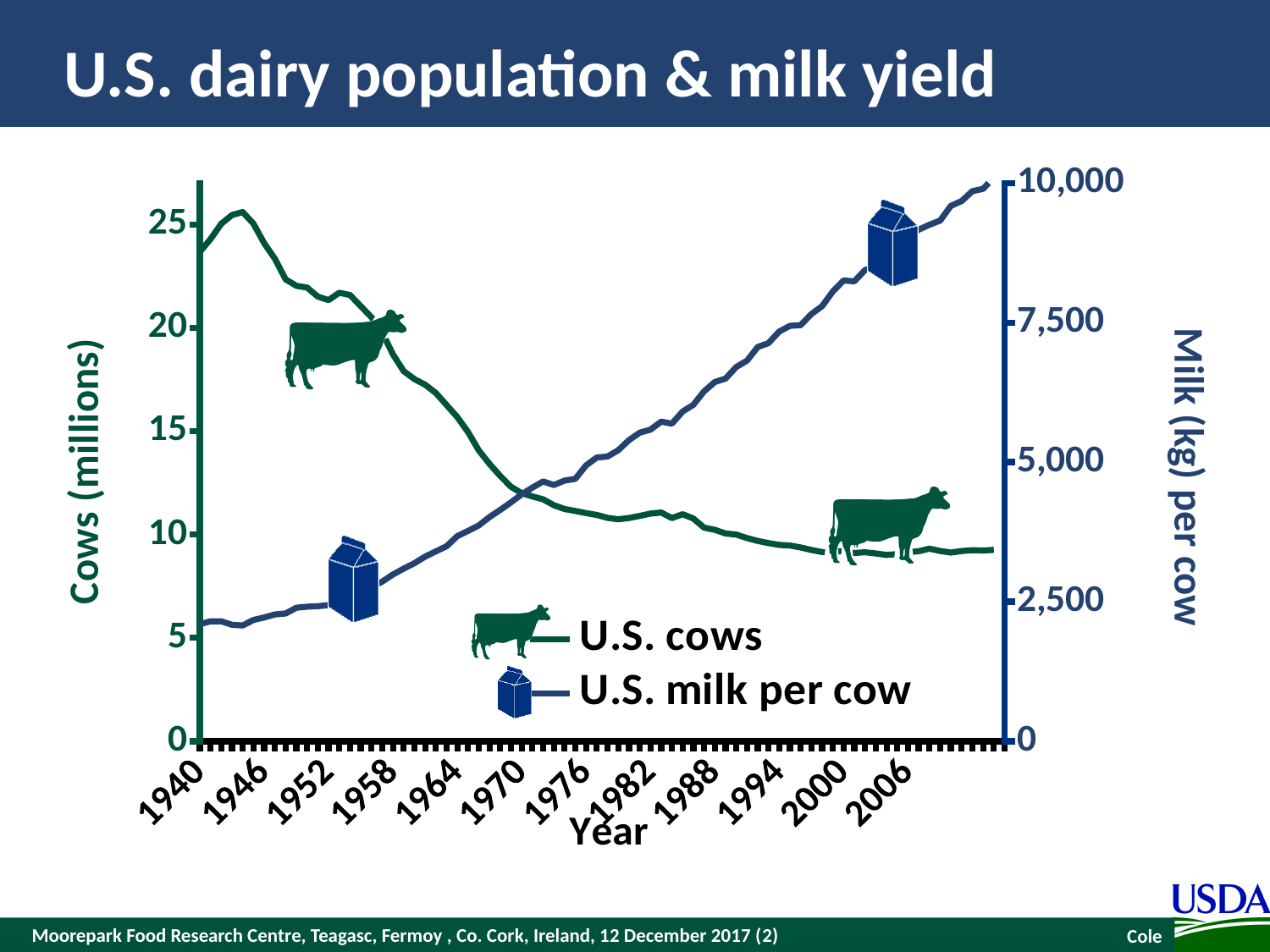
How many series does the legend list? 2 What is the title of the right vertical axis? Milk (kg) per cow Is the value for U.S. cows in 1940 greater or less than 20 million? greater Does the U.S. cows series rise or fall from 1940 to 2006? fall Does the U.S. milk per cow series rise or fall from 1940 to 2006? rise What is the title of the left vertical axis? Cows (millions) Is the value for U.S. cows in 1970 greater or less than 15 million? less Is the value for U.S. milk per cow in 2006 greater or less than 7,500 kg? greater What kind of chart is shown on the slide? line chart Which year has the larger number of U.S. cows, 1940 or 2006? 1940